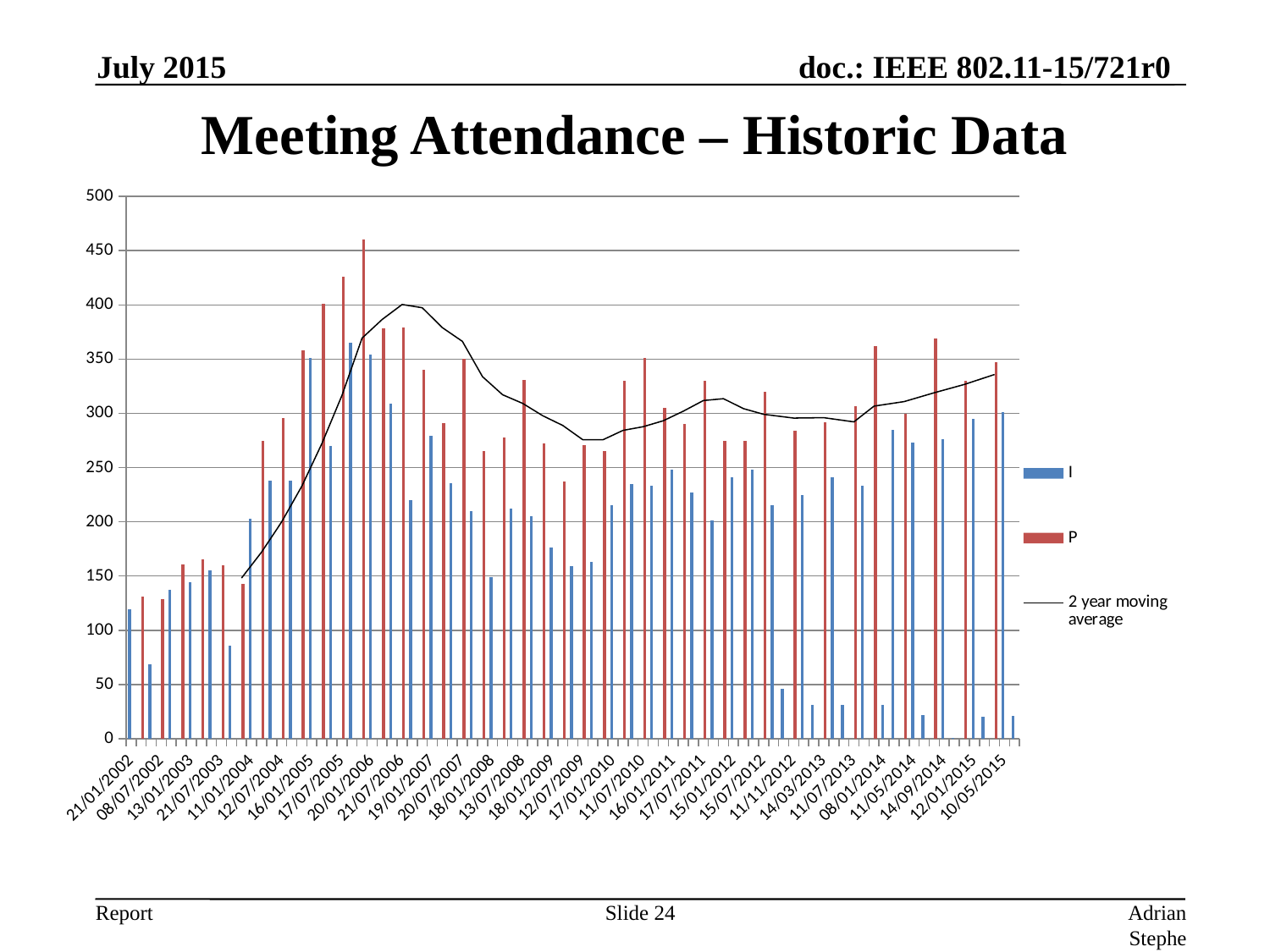
How many series does the legend list? 3 Is the peak of the 2 year moving average line greater or less than 450? less Which series, I or P, has the tallest bar in the chart? P What is the title of the chart? Meeting Attendance – Historic Data Which colour represents the P series in the chart? red Is the peak of the 2 year moving average line greater or less than 350? greater What is the highest value shown on the vertical axis? 500 Does the 2 year moving average line rise or fall between 11/01/2004 and 21/07/2006? rise Is the tallest P bar greater or less than 450? greater What kind of chart is shown on the slide? bar chart Does the 2 year moving average line rise or fall between 21/07/2006 and 12/07/2009? fall